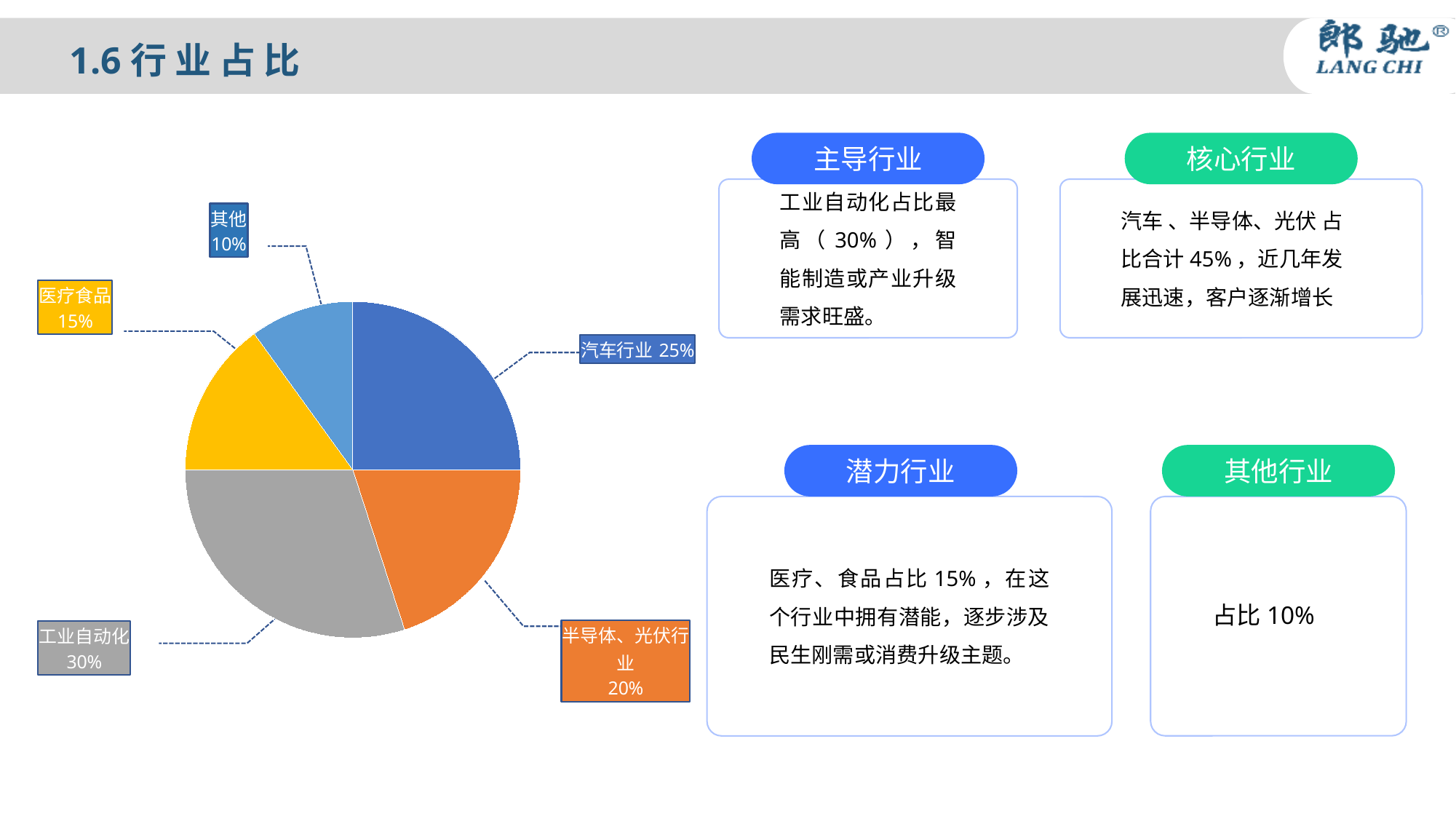
What share of the pie does 工业自动化 have? 30% What share of the pie does 医疗食品 have? 15% Which is larger, the share of 汽车行业 or the share of 半导体、光伏行业? 汽车行业 What share of the pie does 其他 have? 10% Which category has the smallest slice of the pie? 其他 What kind of chart is shown on the slide? pie chart How many slices does the pie chart have? 5 What is the difference between the shares of 工业自动化 and 医疗食品? 15% What colour is the 工业自动化 slice of the pie? grey Which category has the largest slice of the pie? 工业自动化